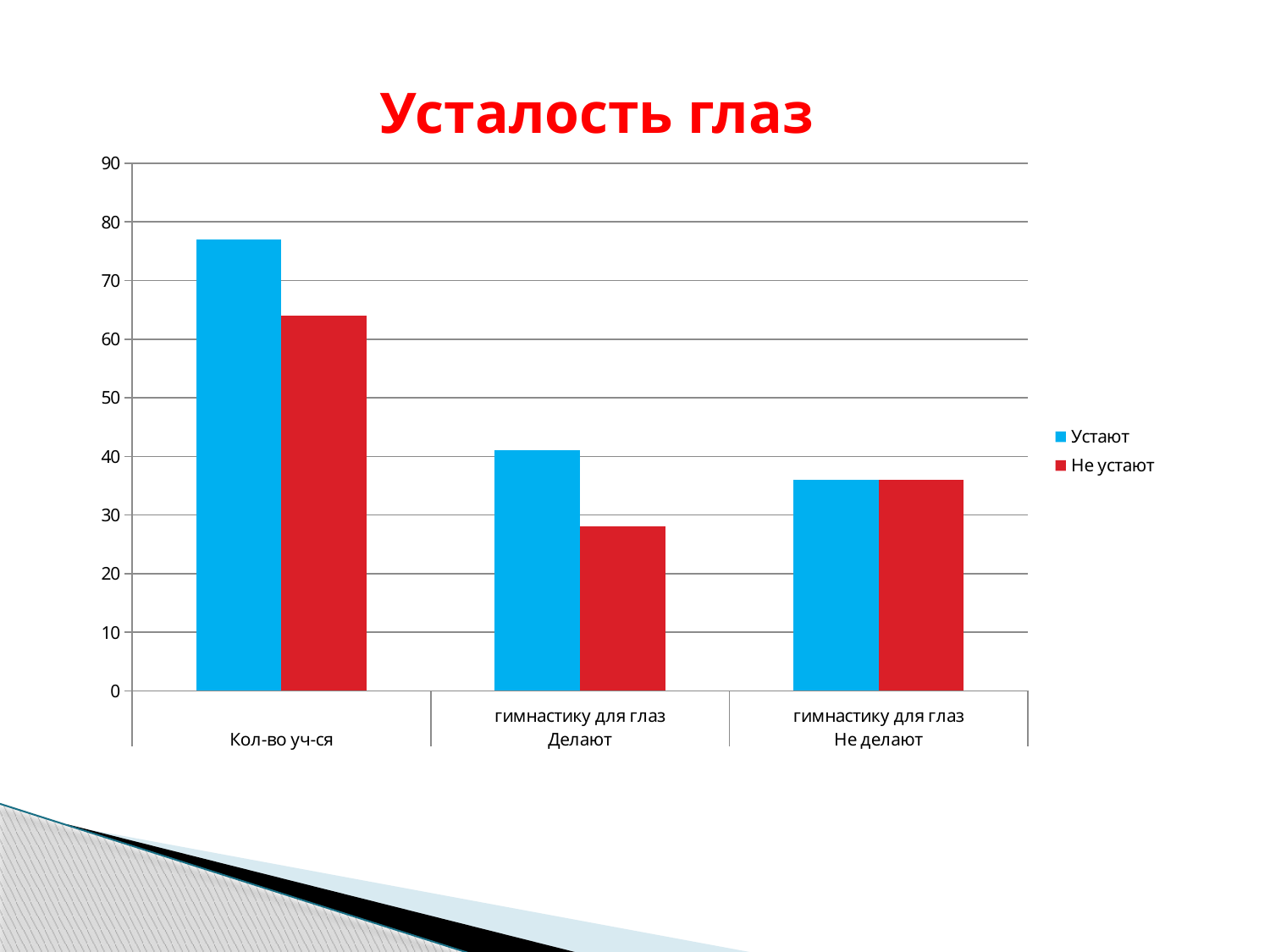
Which category has the lowest value for the Не устают series? гимнастику для глаз Делают What is the title of the chart? Усталость глаз In the гимнастику для глаз Делают category, which is larger: Устают or Не устают? Устают How many categories are shown on the x axis? 3 Is the value for Не устают in the Кол-во уч-ся category greater or less than 70? less Which series is shown in red in the legend? Не устают Is the value for Не устают in the гимнастику для глаз Делают category greater or less than 30? less How many series does the legend list? 2 Is the value for Устают in the Кол-во уч-ся category greater or less than 70? greater Which category has the highest value for the Устают series? Кол-во уч-ся What kind of chart is shown on the slide? bar chart